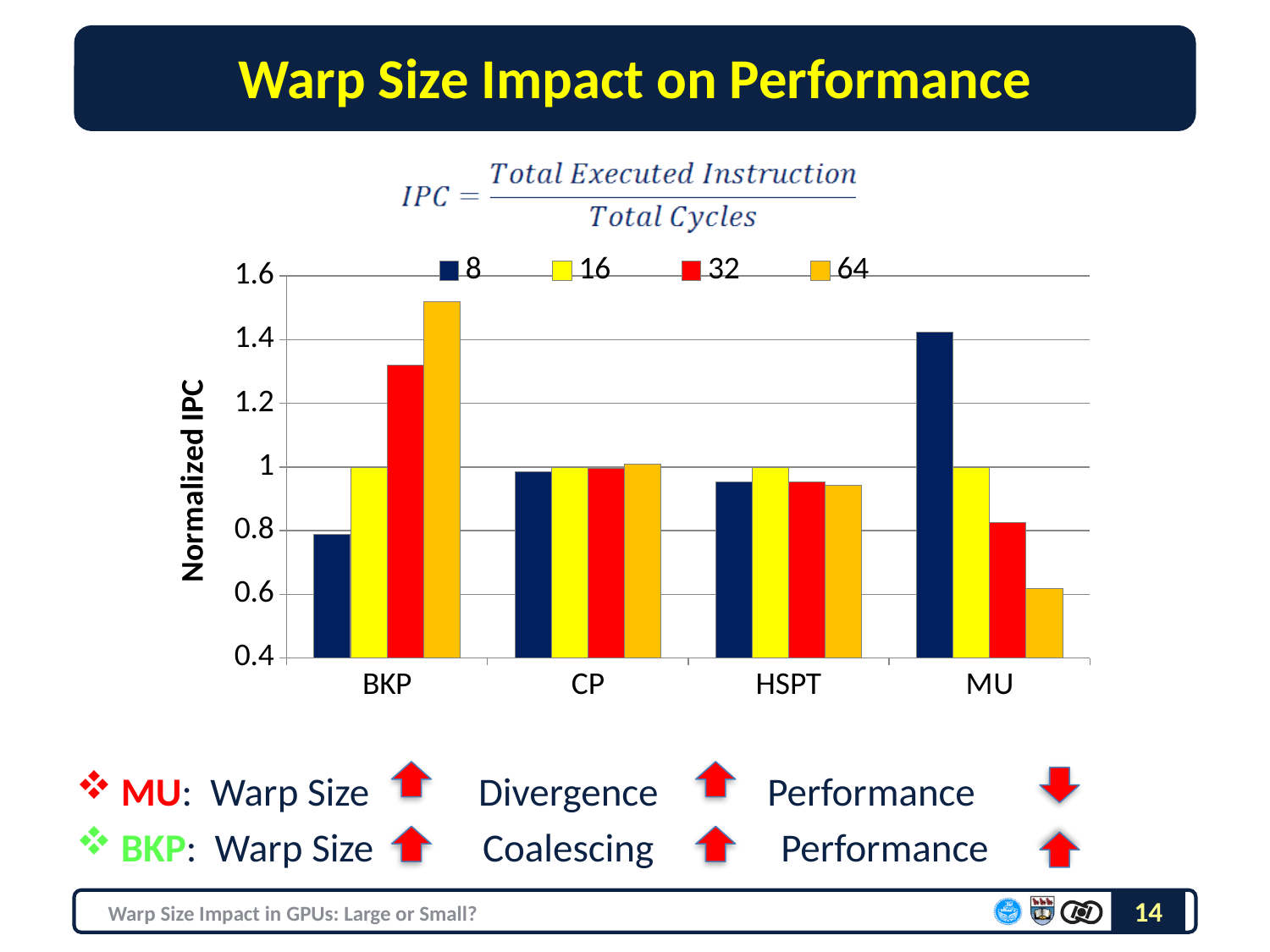
Is the normalized IPC for warp size 64 in the MU category greater or less than 0.8? less Is the normalized IPC for warp size 64 in the BKP category greater or less than 1.4? greater What is the label of the chart's y axis? Normalized IPC How many series does the chart's legend list? 4 For the BKP category, which warp size has the highest normalized IPC? 64 For the MU category, do the normalized IPC values rise or fall as the warp size increases from 8 to 64? fall What kind of chart is shown on the slide? bar chart For the MU category, which warp size has the lowest normalized IPC? 64 How many categories are shown on the x axis of the chart? 4 Which warp sizes are listed in the chart's legend? 8, 16, 32, 64 Which is larger: the normalized IPC for warp size 32 in BKP or for warp size 32 in MU? warp size 32 in BKP For the MU category, which warp size has the highest normalized IPC? 8